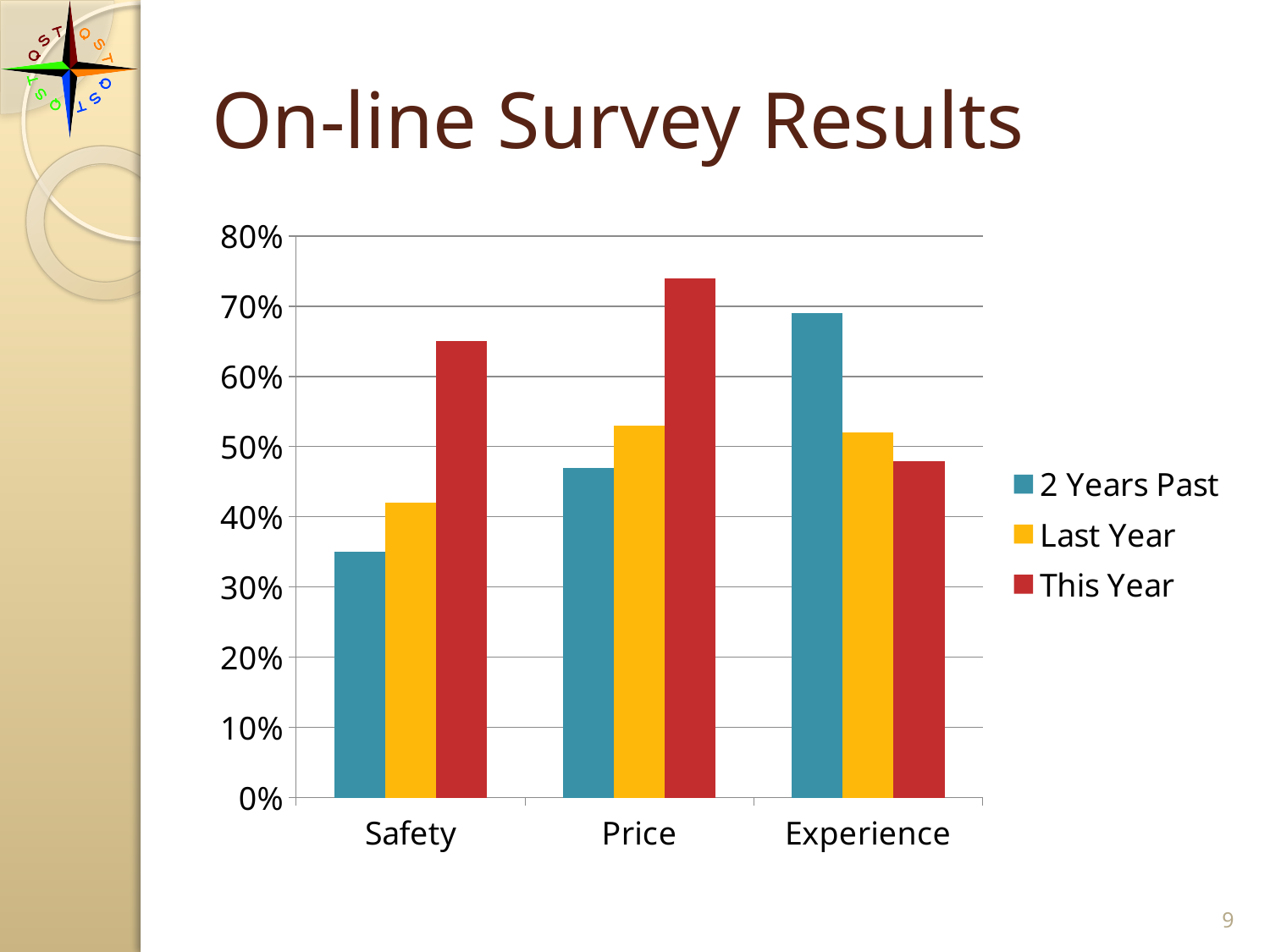
Which is larger: the This Year value for Safety or the This Year value for Experience? Safety Is the value for Price in the This Year series greater or less than 70%? greater What is the title of the slide containing the chart? On-line Survey Results Which colour represents the "This Year" series? Red Which series has the highest value for Experience? 2 Years Past How many series does the legend list? 3 Which series has the lowest value for Safety? 2 Years Past Which category and series has the tallest bar in the chart? Price, This Year How many categories are shown on the x axis? 3 Do the values for the 2 Years Past series rise or fall from Safety to Experience? Rise Is the value for Safety in the This Year series greater or less than 60%? greater What kind of chart is shown on the slide? Bar chart